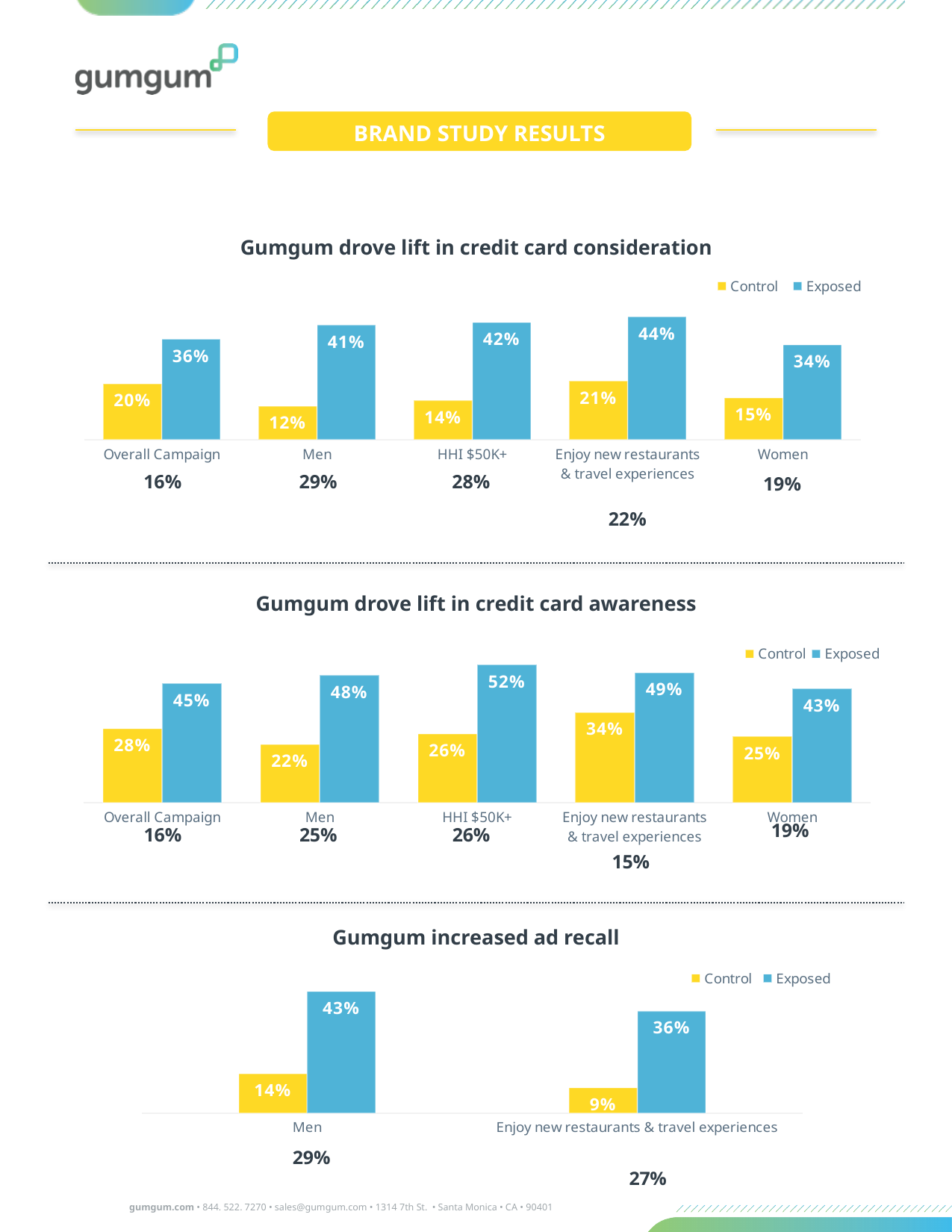
In the chart titled 'Gumgum drove lift in credit card awareness', what is the Exposed value for HHI $50K+? 52% In the chart titled 'Gumgum drove lift in credit card awareness', which category has the highest Control value? Enjoy new restaurants & travel experiences In the chart titled 'Gumgum drove lift in credit card consideration', which category has the highest Exposed value? Enjoy new restaurants & travel experiences In the chart titled 'Gumgum drove lift in credit card consideration', what is the difference between the Exposed and Control values for HHI $50K+? 28% In the chart titled 'Gumgum increased ad recall', what is the Control value for Enjoy new restaurants & travel experiences? 9% What kind of chart is 'Gumgum increased ad recall'? Bar chart In the chart titled 'Gumgum drove lift in credit card consideration', what is the Control value for Women? 15% In the chart titled 'Gumgum increased ad recall', what is the difference between the Exposed and Control values for Men? 29% In the chart titled 'Gumgum drove lift in credit card awareness', how many categories are shown on the x axis? 5 In the chart titled 'Gumgum drove lift in credit card consideration', which category has the lowest Control value? Men In the chart titled 'Gumgum drove lift in credit card awareness', is the Control value for Overall Campaign larger or the Control value for Women? Overall Campaign In the chart titled 'Gumgum drove lift in credit card consideration', what is the Exposed value for Men? 41%